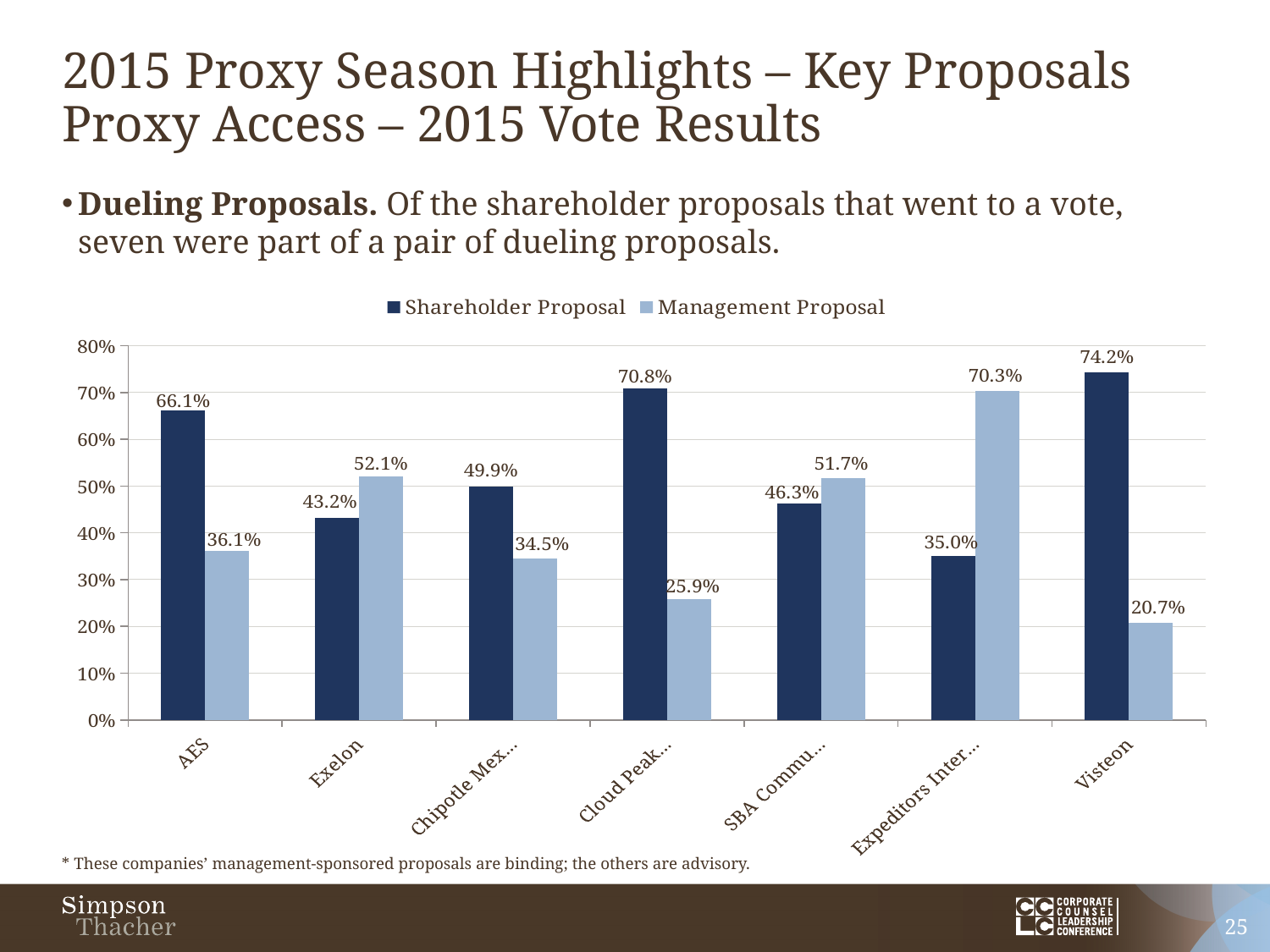
What is the Management Proposal value for Visteon? 20.7% Which company has the lowest Management Proposal value? Visteon How many series does the legend list? 2 What is the difference between the Shareholder Proposal and Management Proposal values for AES? 30.0 percentage points For Exelon, which is larger: the Shareholder Proposal or the Management Proposal value? Management Proposal How many companies are shown on the x axis of the chart? 7 What is the Shareholder Proposal value for AES? 66.1% What is the Shareholder Proposal value for Exelon? 43.2% Which company has the highest Shareholder Proposal value? Visteon Which series is shown in dark blue in the legend? Shareholder Proposal Is the Management Proposal value for Cloud Peak greater or less than 30%? less What kind of chart is shown on the slide? bar chart